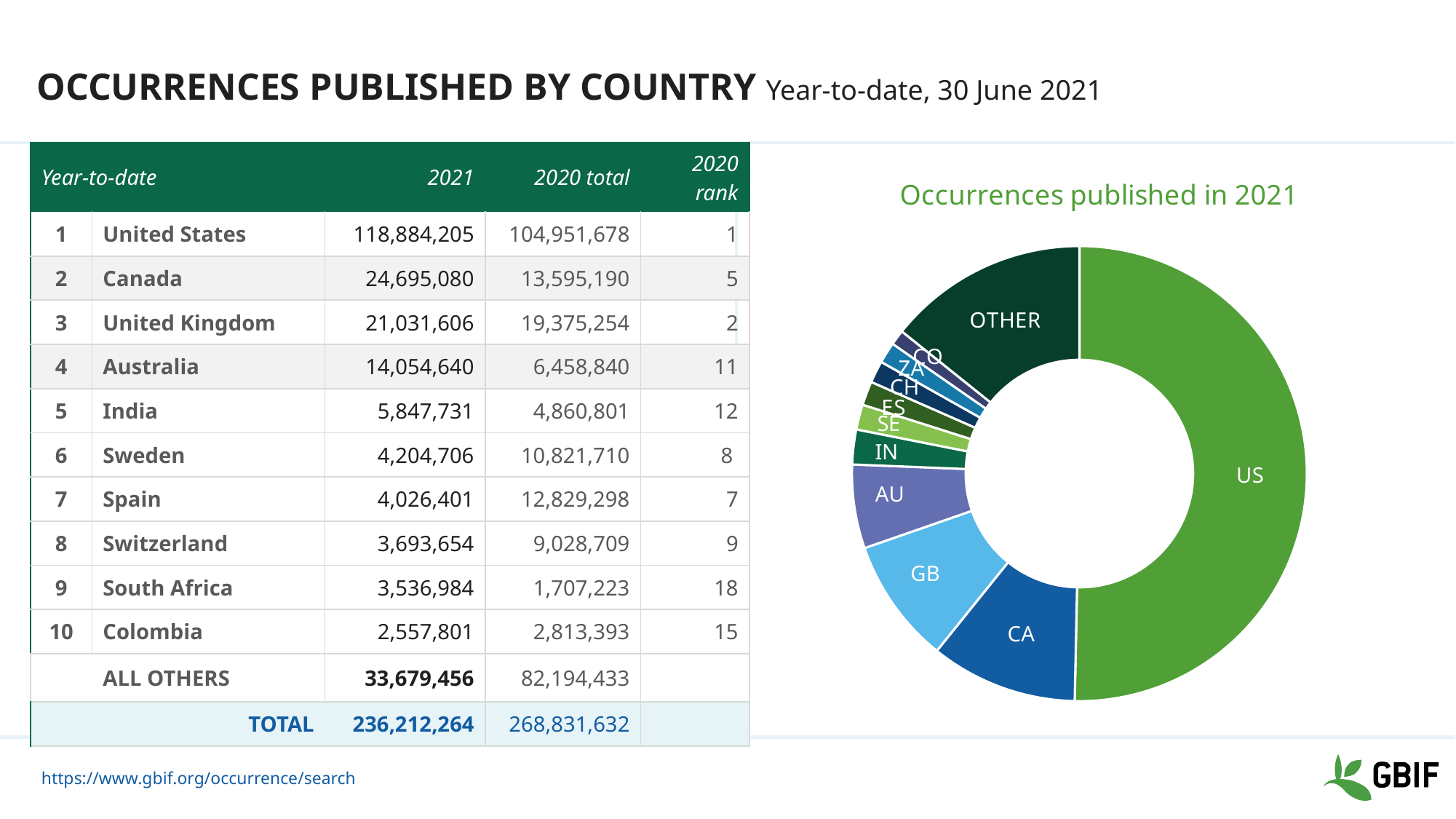
How many slices does the pie chart have? 11 Which slice of the pie chart is the largest? US What is the title of the chart on the right? Occurrences published in 2021 Which labelled country slice of the pie chart is the smallest? CO How many occurrences does the AU slice of the pie chart represent, according to the table on the slide? 14,054,640 Using the 2021 values in the table, how many more occurrences does the CA slice represent than the GB slice? 3,663,474 In the pie chart, which slice is larger, US or OTHER? US What kind of chart is shown on the right of the slide? doughnut chart In the pie chart, which slice is larger, AU or IN? AU How many occurrences does the US slice of the pie chart represent, according to the table on the slide? 118,884,205 What colour is the US slice of the pie chart? green In the pie chart, which slice is larger, CA or GB? CA